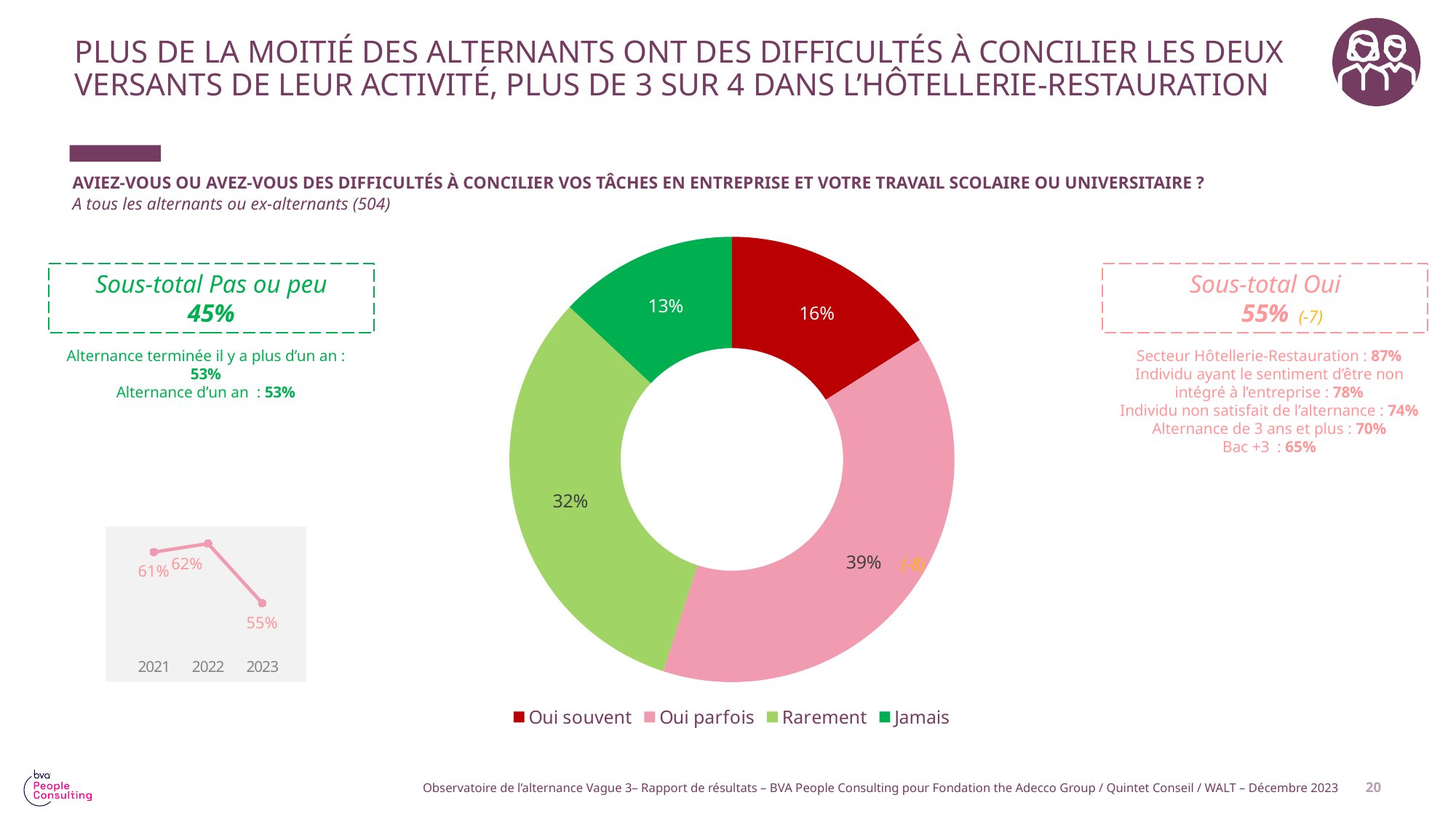
In the small line chart at the bottom left, how many years are plotted? 3 In the donut chart, what share is labelled for 'Jamais'? 13% In the small line chart at the bottom left, what is the value for 2022? 62% How many categories does the legend of the donut chart list? 4 In the donut chart, what share is labelled for 'Oui parfois'? 39% In the donut chart, what share is labelled for 'Oui souvent'? 16% In the donut chart, which category has the largest slice? Oui parfois In the donut chart, what is the difference between the 'Oui parfois' and 'Rarement' shares? 7 percentage points In the donut chart, which category has the smallest slice? Jamais In the small line chart at the bottom left, does the value rise or fall from 2022 to 2023? Fall In the donut chart, which is larger: 'Oui souvent' or 'Rarement'? Rarement What kind of chart is the large chart in the centre of the slide? Donut (pie) chart